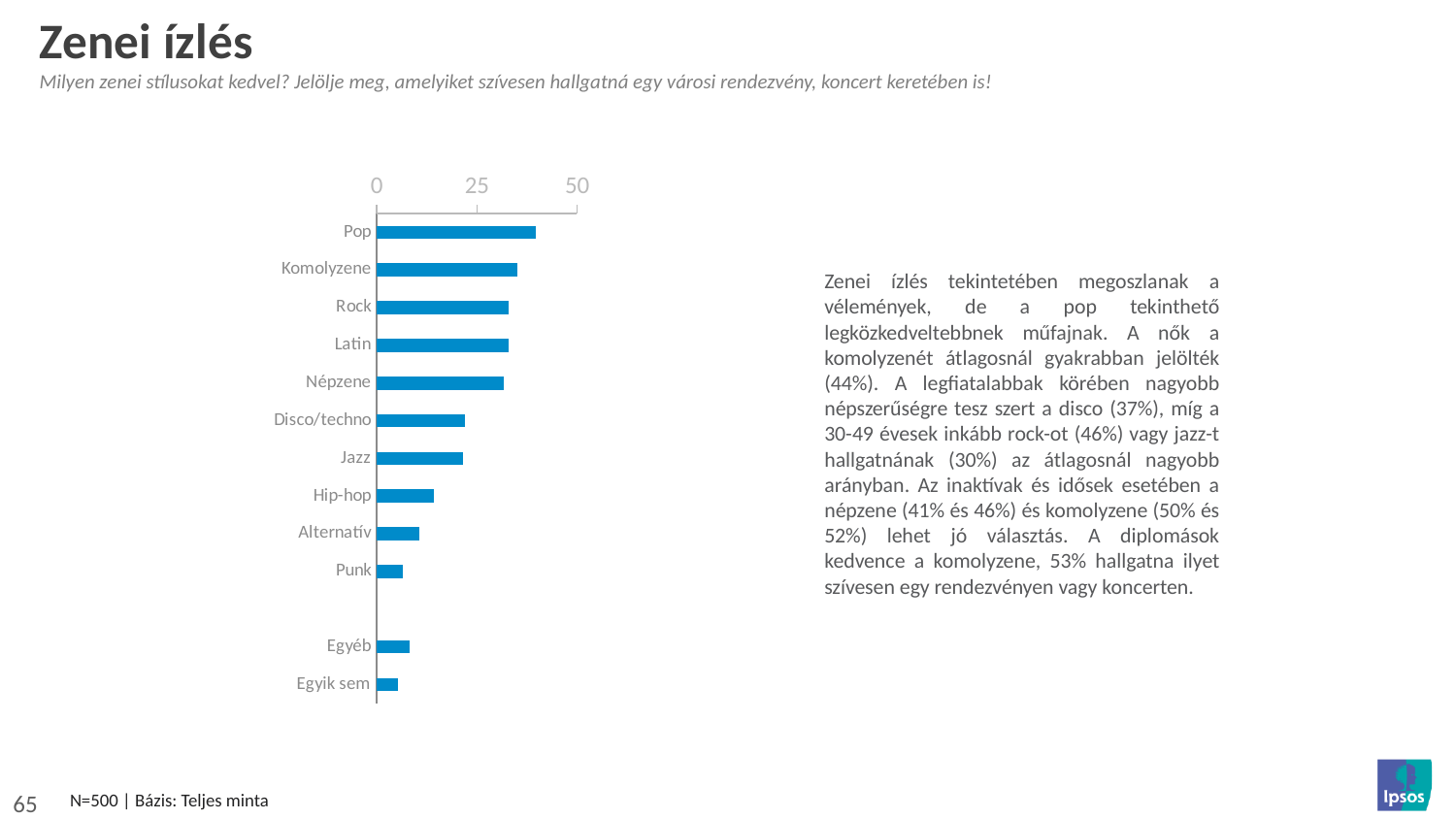
Is the value for Népzene greater or less than 25? greater Which has a larger value, Pop or Punk? Pop Which category has the highest value in the chart? Pop What is the title of the slide containing the chart? Zenei ízlés Is the value for Hip-hop greater or less than 25? less Is the value for Punk greater or less than 25? less What kind of chart is shown on the slide? bar chart Which has a larger value, Komolyzene or Hip-hop? Komolyzene How many categories are plotted in the chart? 12